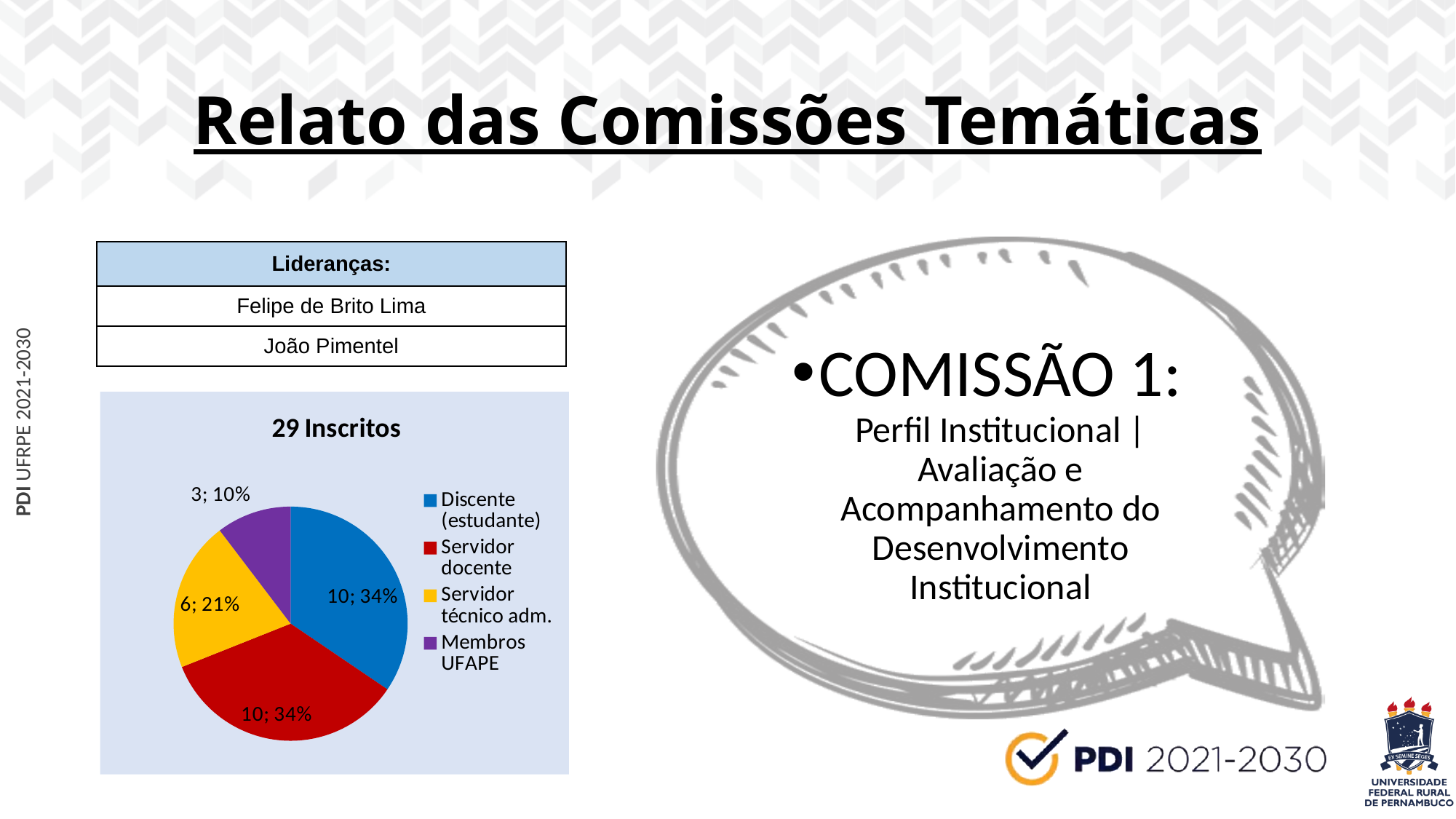
What share of the pie does Membros UFAPE represent? 10% What is the value for Servidor técnico adm. in the pie chart? 6 How many entries does the legend of the pie chart list? 4 Which is larger in the pie chart, Servidor técnico adm. or Membros UFAPE? Servidor técnico adm. What is the value for Discente (estudante) in the pie chart? 10 Which category has the smallest slice in the pie chart? Membros UFAPE What is the value for Membros UFAPE in the pie chart? 3 What kind of chart is shown on the slide? pie chart What share of the pie does Servidor técnico adm. represent? 21% What is the title of the pie chart? 29 Inscritos What is the difference between the values for Servidor docente and Membros UFAPE? 7 How many slices does the pie chart have? 4